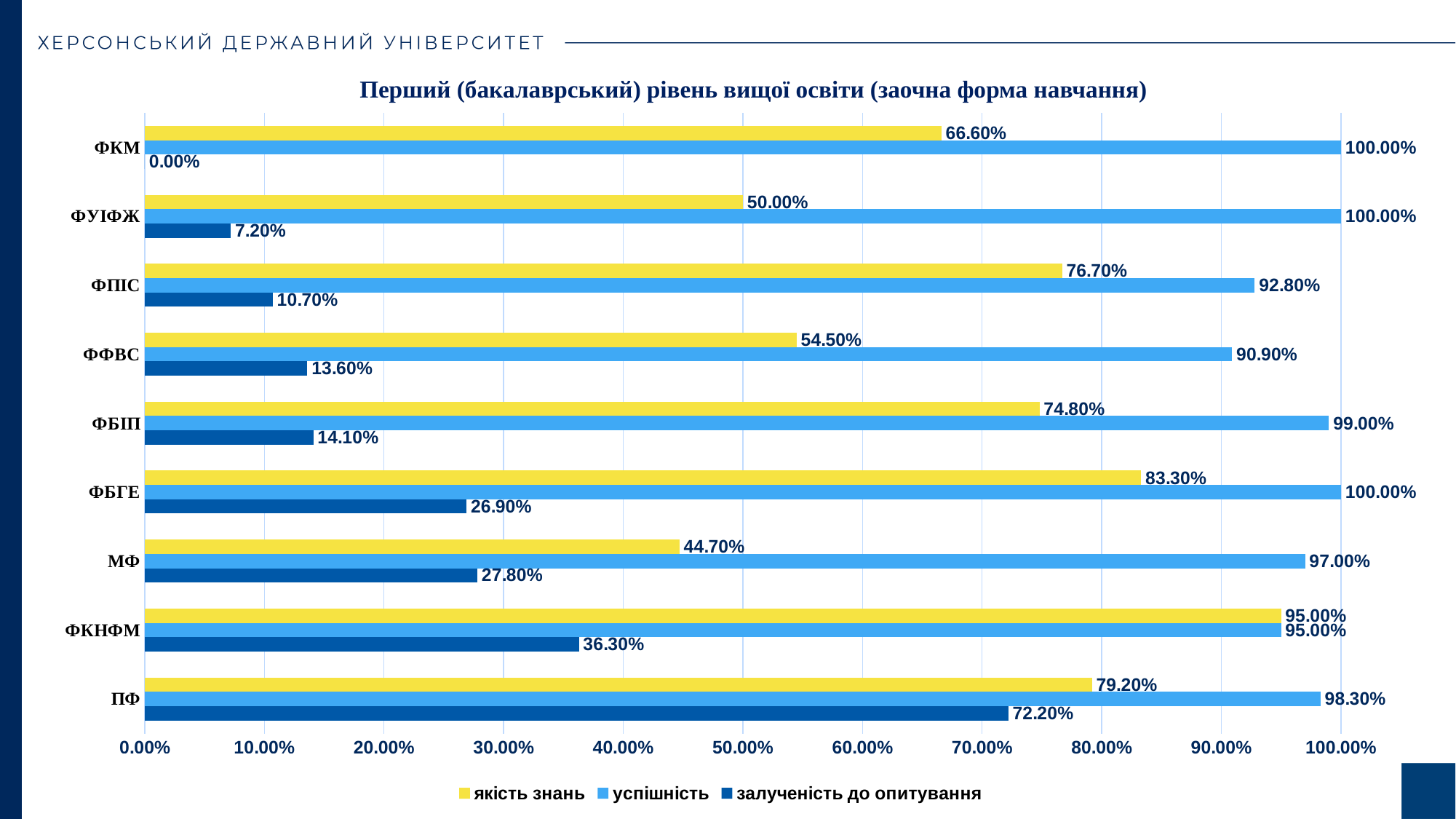
How many series does the legend list? 3 What is the value of 'залученість до опитування' for ПФ? 72.20% What is the value of 'успішність' for ФПІС? 92.80% What is the title of the chart? Перший (бакалаврський) рівень вищої освіти (заочна форма навчання) What type of chart is shown on the slide? bar chart Which faculty has the lowest value for 'якість знань'? МФ Is the value of 'залученість до опитування' for ФКНФМ greater or less than 30.00%? greater What is the value of 'якість знань' for ФКМ? 66.60% Which faculty has the highest value for 'залученість до опитування'? ПФ How many faculties (categories) are shown on the chart? 9 What is the difference between 'якість знань' and 'залученість до опитування' for ФБГЕ? 56.40% Which is larger for ФФВС: 'якість знань' or 'успішність'? успішність